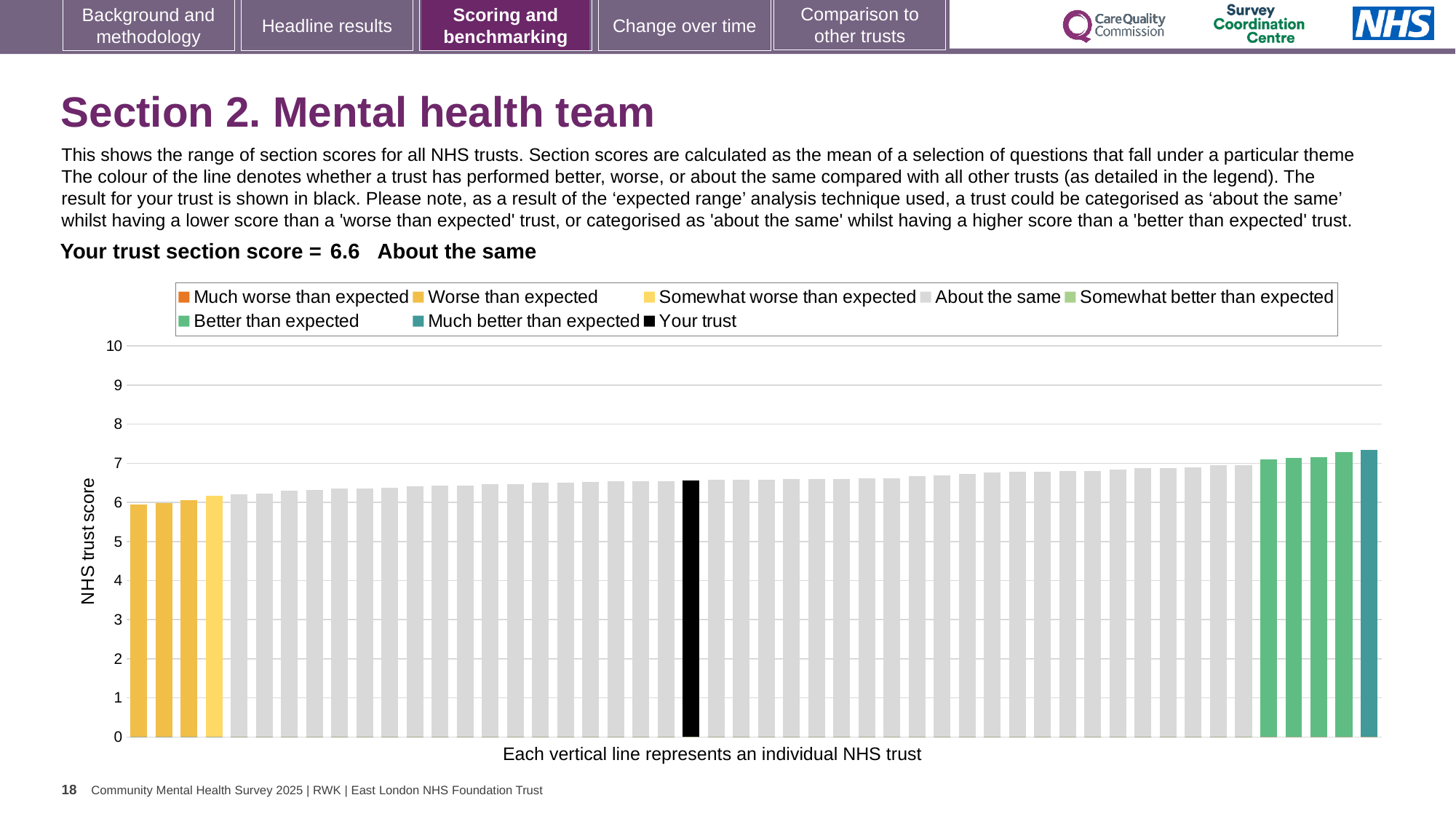
What is the label on the vertical axis of the chart? NHS trust score Do the bar values rise or fall moving from left to right along the x axis? rise Is the value of the tallest bar (rightmost trust) greater or less than 7? greater What is the highest value shown on the vertical axis? 10 Is the value for your trust (the black bar) greater or less than 5? greater What kind of chart is shown on the slide? bar chart Is the value of the leftmost bar greater or less than 7? less How many entries does the chart legend list? 8 How is your trust's section score categorised compared with other trusts? About the same What is the section score for your trust shown on the slide? 6.6